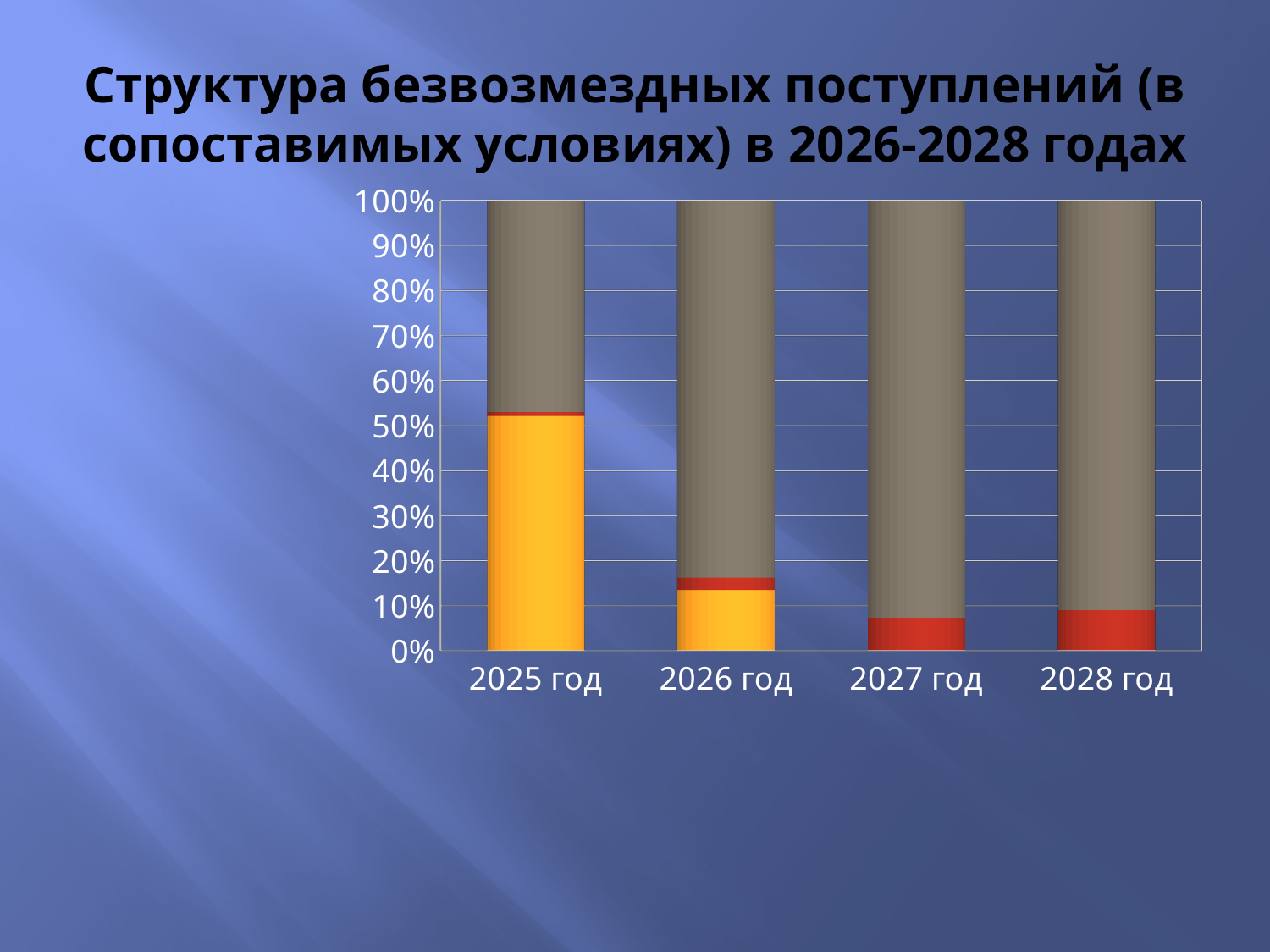
What is the highest value shown on the vertical axis? 100% Is the grey segment for 2027 год greater or less than 80%? greater Which year has the largest yellow segment in its bar? 2025 год How many years (categories) are shown on the x axis of the chart? 4 Is the yellow segment for 2025 год greater or less than 40%? greater Which is larger, the yellow segment for 2025 год or the yellow segment for 2026 год? 2025 год Does the yellow segment rise or fall from 2025 год to 2026 год? fall Is the yellow segment for 2026 год greater or less than 20%? less What is the title of the chart on the slide? Структура безвозмездных поступлений (в сопоставимых условиях) в 2026-2028 годах What kind of chart is shown on the slide? stacked bar chart Which year has the largest grey segment in its bar? 2027 год